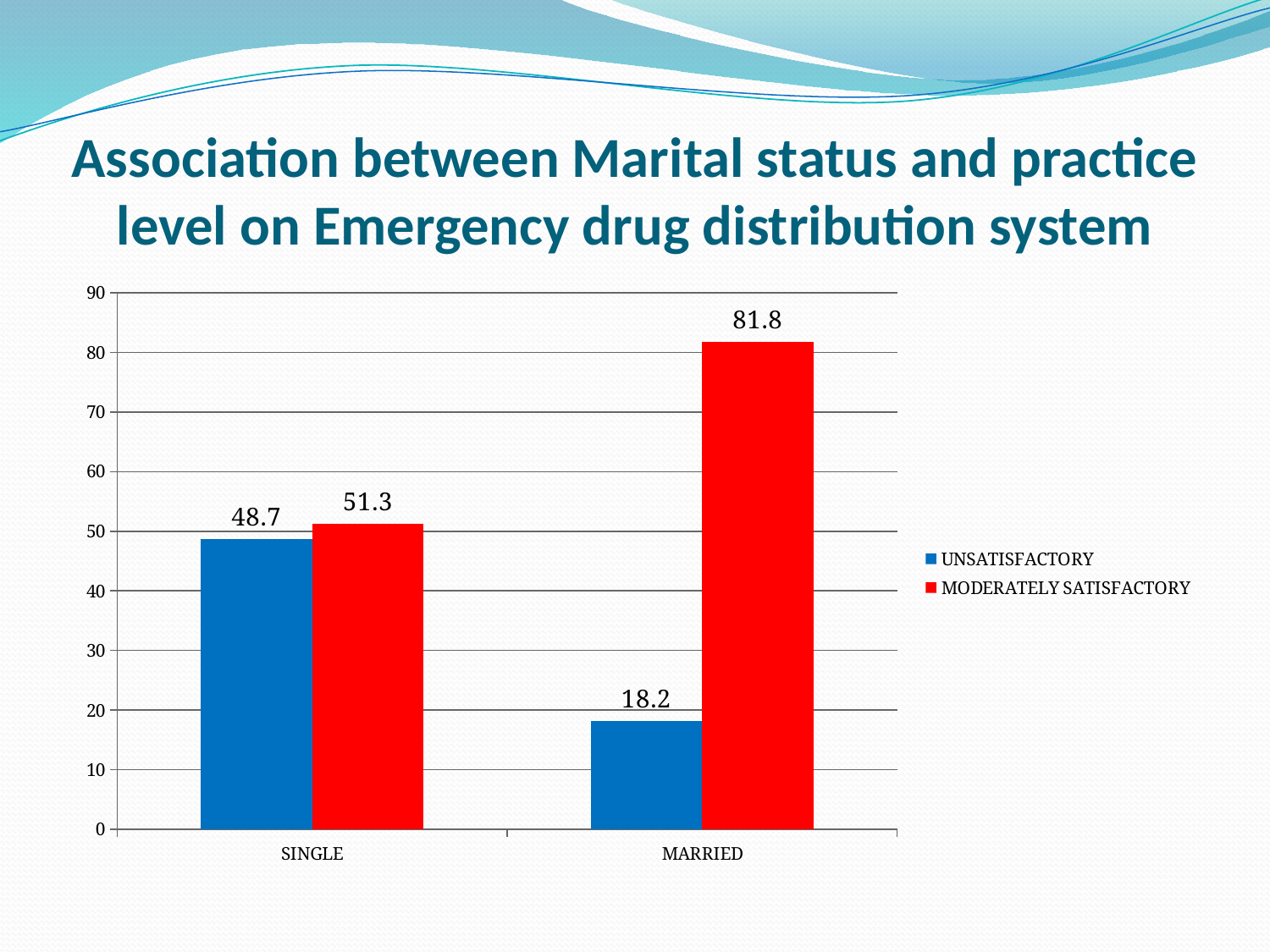
How many series does the legend list? 2 How many categories are shown on the x axis? 2 Which category has the highest MODERATELY SATISFACTORY value? MARRIED What kind of chart is shown on the slide? bar chart Which is larger for SINGLE: the UNSATISFACTORY value or the MODERATELY SATISFACTORY value? MODERATELY SATISFACTORY Is the MODERATELY SATISFACTORY value for MARRIED greater or less than 70? greater What is the MODERATELY SATISFACTORY value for MARRIED? 81.8 Which category has the lowest UNSATISFACTORY value? MARRIED What is the difference between the MODERATELY SATISFACTORY and UNSATISFACTORY values for MARRIED? 63.6 What is the UNSATISFACTORY value for SINGLE? 48.7 What is the UNSATISFACTORY value for MARRIED? 18.2 What is the MODERATELY SATISFACTORY value for SINGLE? 51.3